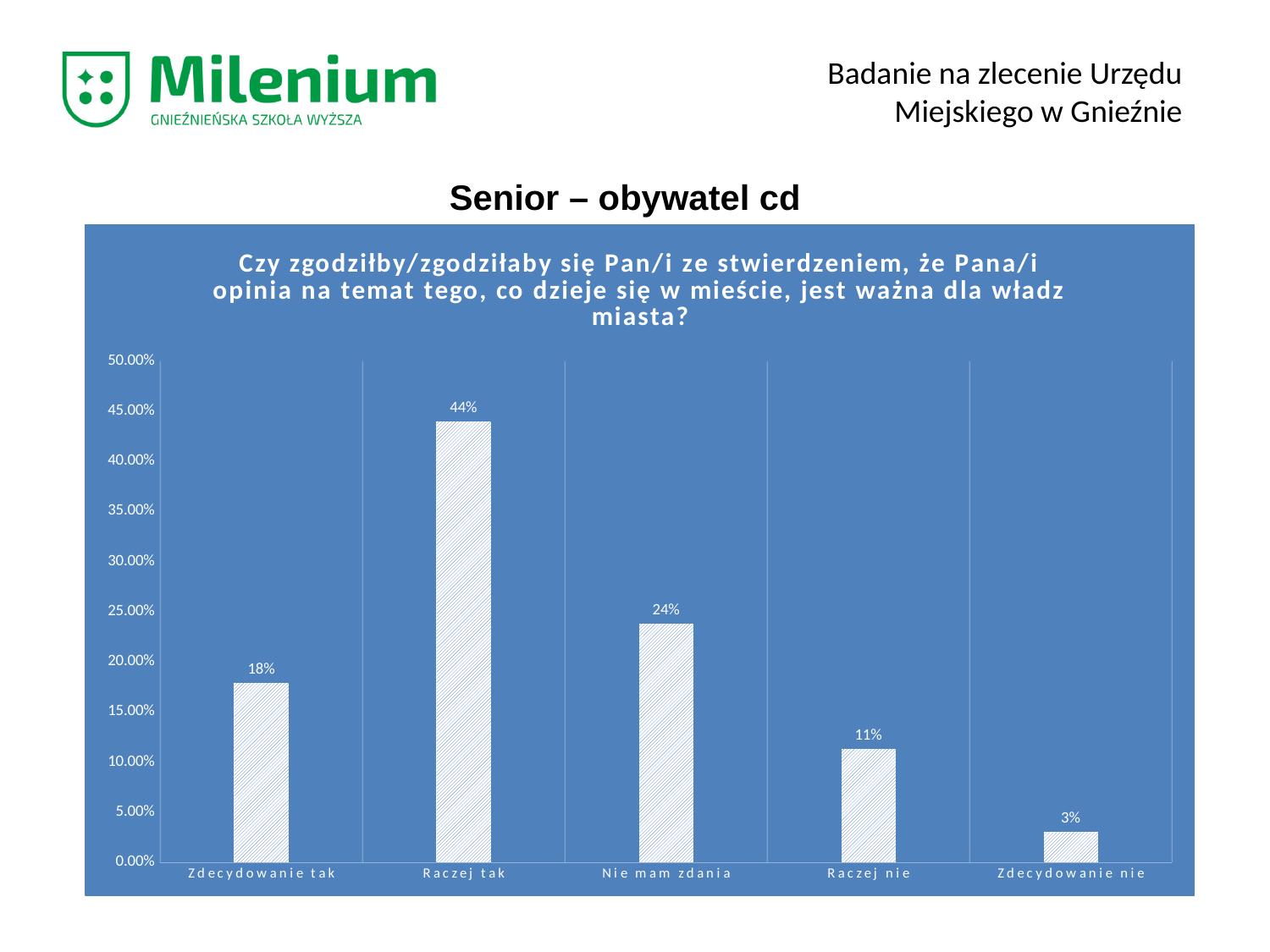
What is the difference between the values for "Raczej tak" and "Nie mam zdania"? 20% Is the value for "Raczej nie" greater or less than 15.00%? less Which is larger, the value for "Zdecydowanie tak" or the value for "Raczej nie"? Zdecydowanie tak How many categories are shown on the x axis? 5 What is the value for "Zdecydowanie tak"? 18% What is the value for "Raczej tak"? 44% What is the label of the first category on the x axis? Zdecydowanie tak What is the value for "Zdecydowanie nie"? 3% What is the value for "Nie mam zdania"? 24% Which category has the highest value? Raczej tak What kind of chart is shown on the slide? bar chart Which category has the lowest value? Zdecydowanie nie